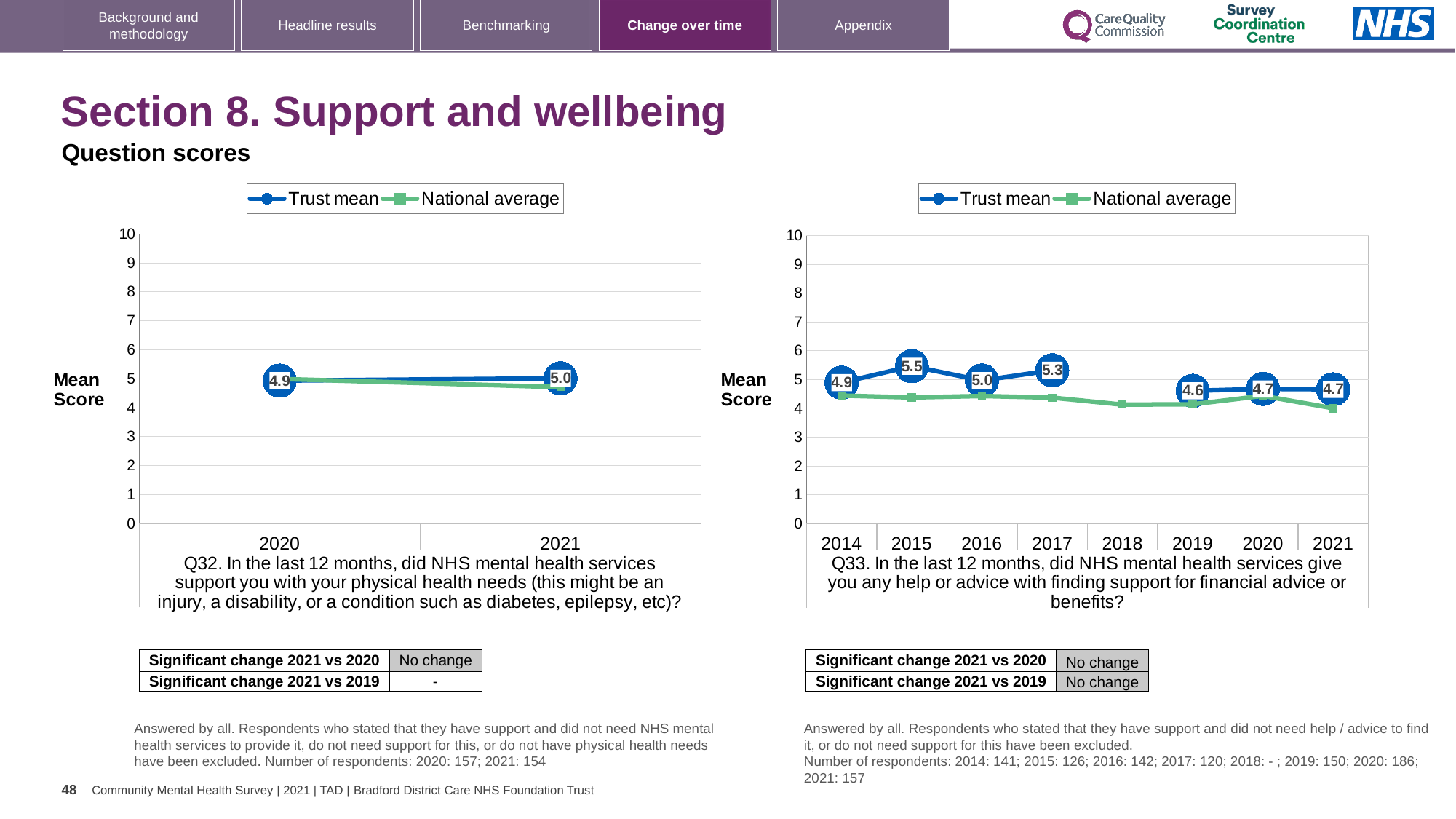
On the Q33 chart (right), what is the difference between the Trust mean in 2015 and in 2021? 0.8 On the Q32 chart (left), what is the Trust mean for 2020? 4.9 On the Q33 chart (right), which year has the lowest labelled Trust mean? 2019 What type of chart is the Q33 chart (right)? Line chart On the Q33 chart (right), is the Trust mean higher in 2017 or in 2016? 2017 On the Q33 chart (right), is the National average for 2021 greater or less than 5? less How many years are shown on the x axis of the Q33 chart (right)? 8 On the Q32 chart (left), what is the Trust mean for 2021? 5.0 On the Q33 chart (right), what is the Trust mean for 2019? 4.6 On the Q33 chart (right), which year has the highest Trust mean? 2015 On the Q33 chart (right), what is the Trust mean for 2015? 5.5 How many series does the legend of the Q32 chart (left) list? 2